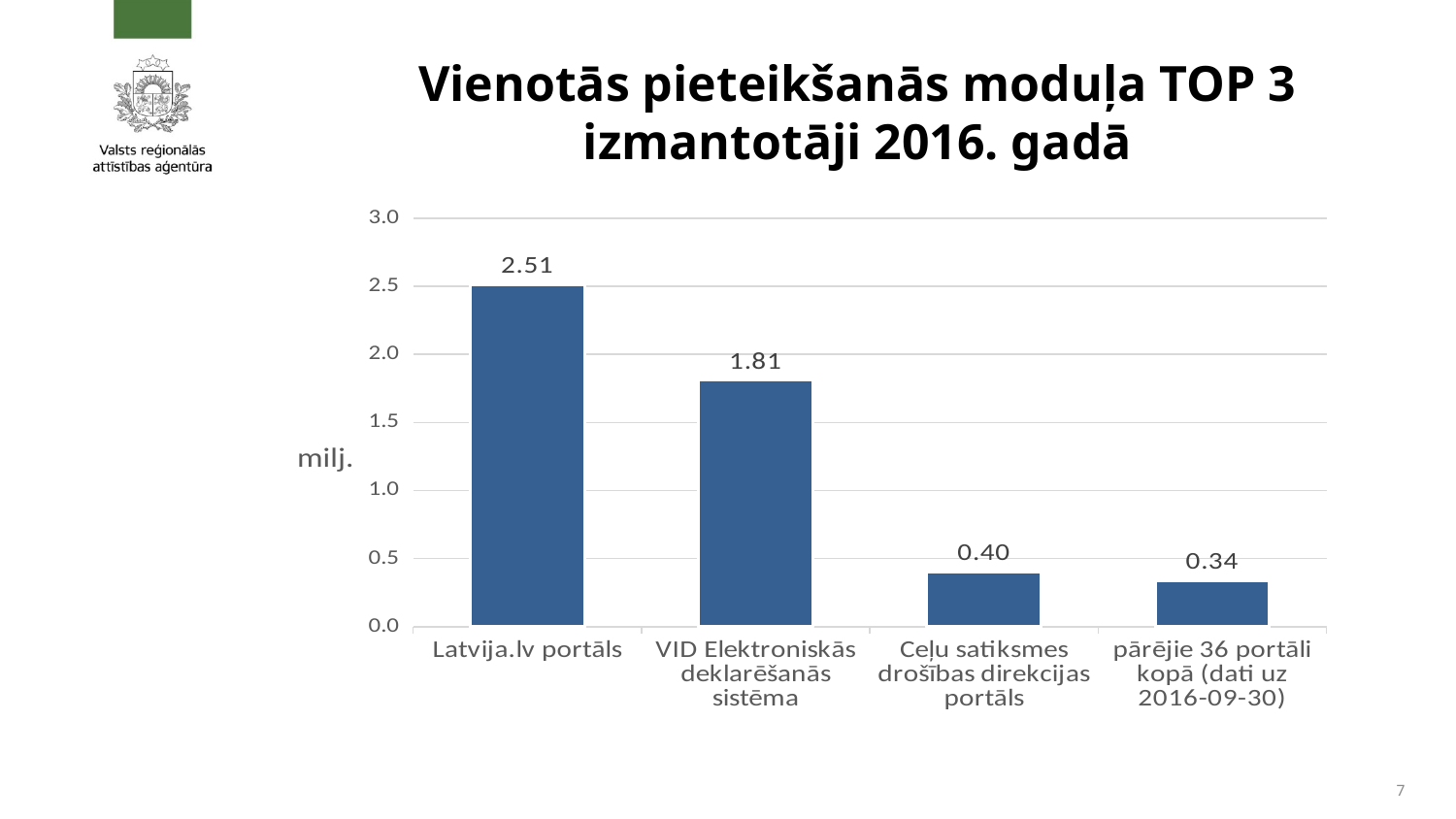
Is the value for Latvija.lv portāls greater or less than 2.0? greater What kind of chart is shown on the slide? bar chart What is the value for Ceļu satiksmes drošības direkcijas portāls? 0.40 What is the value for Latvija.lv portāls? 2.51 What is the value for VID Elektroniskās deklarēšanās sistēma? 1.81 Which category has the highest value? Latvija.lv portāls What is the difference between the values for Latvija.lv portāls and VID Elektroniskās deklarēšanās sistēma? 0.70 How many categories are shown on the x axis? 4 Which category has the lowest value? pārējie 36 portāli kopā (dati uz 2016-09-30) What is the label on the vertical axis of the chart? milj. Which is larger: the value for VID Elektroniskās deklarēšanās sistēma or the value for Ceļu satiksmes drošības direkcijas portāls? VID Elektroniskās deklarēšanās sistēma What is the value for pārējie 36 portāli kopā (dati uz 2016-09-30)? 0.34